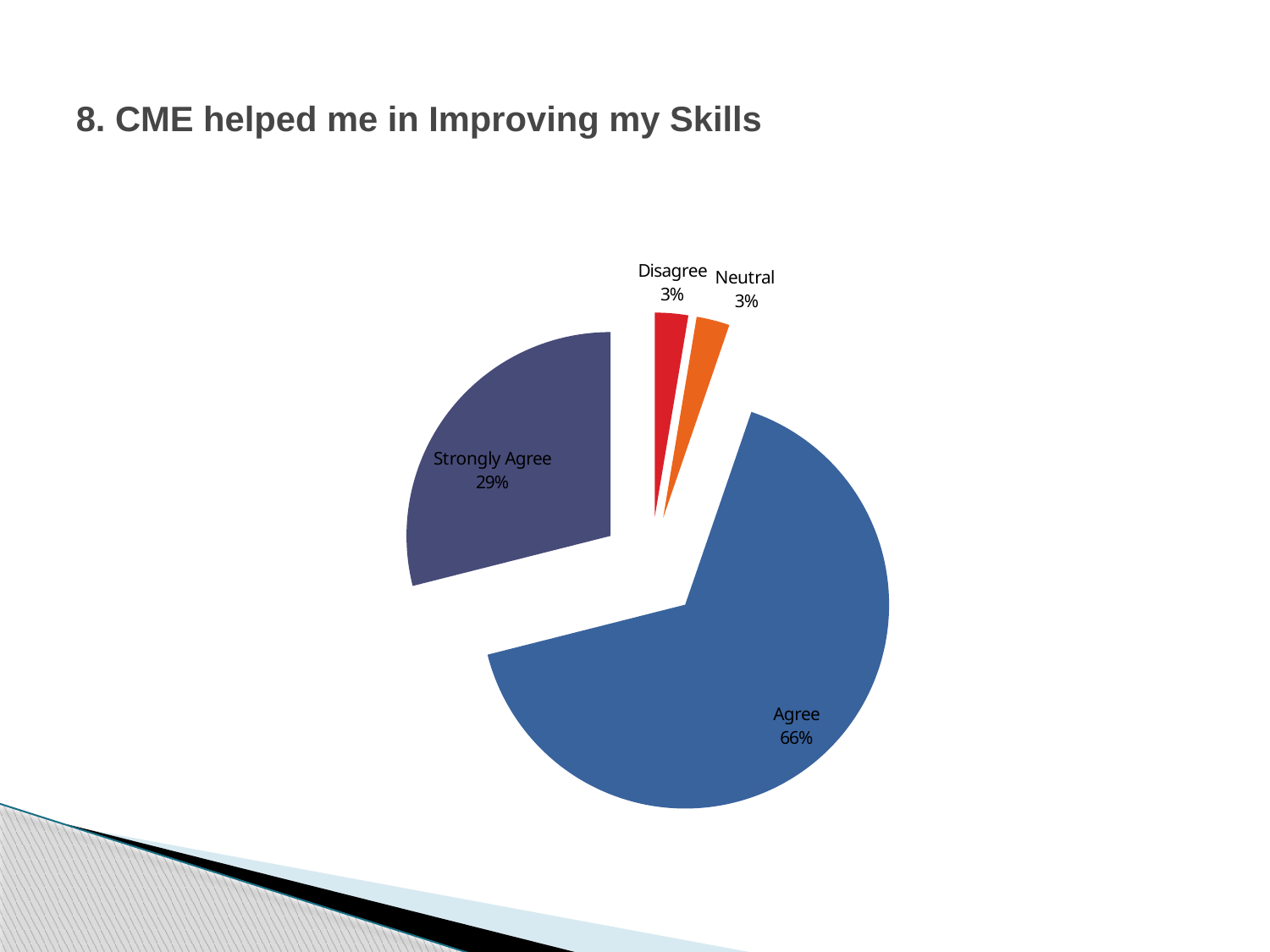
What percentage of respondents chose Neutral? 3% What percentage of respondents chose Strongly Agree? 29% What percentage of respondents chose Disagree? 3% What is the title of the slide containing the pie chart? 8. CME helped me in Improving my Skills What is the difference in percentage points between Agree and Strongly Agree? 37 Which is larger, the share for Strongly Agree or the share for Neutral? Strongly Agree What is the combined share of Agree and Strongly Agree? 95% What kind of chart is shown on the slide? pie chart What colour is the Agree slice? blue Which response has the largest share of the pie? Agree What percentage of respondents chose Agree? 66% How many slices does the pie chart have? 4